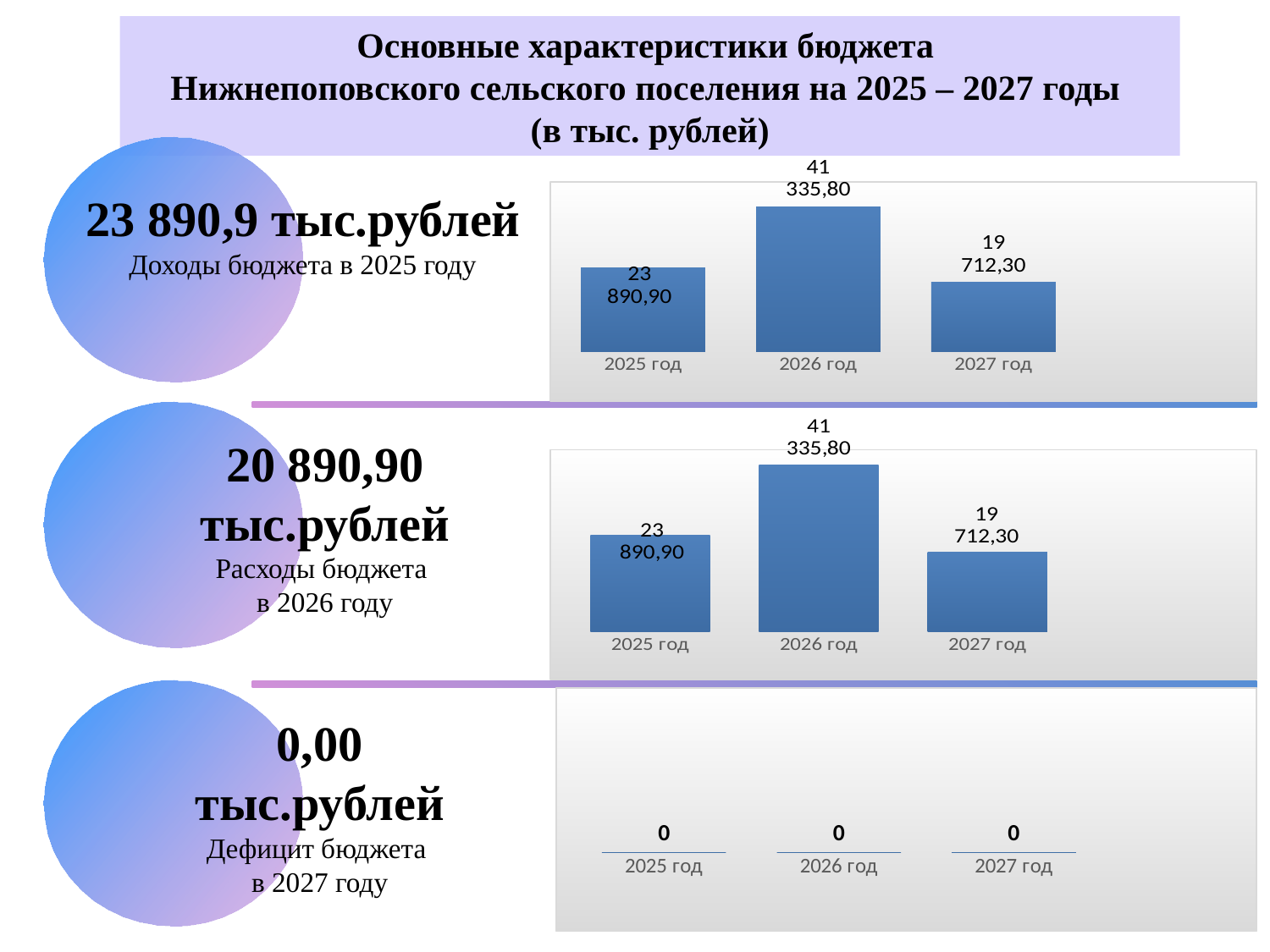
In the bottom chart, what is the value for 2026 год? 0 In the top chart, what is the value for 2026 год? 41 335,80 In the top chart, which year has the lowest value? 2027 год In the middle chart, which is larger, the value for 2025 год or the value for 2027 год? 2025 год In the middle chart, what is the difference between the values for 2026 год and 2025 год? 17 444,90 In the middle chart, what is the value for 2027 год? 19 712,30 In the top chart, what is the value for 2025 год? 23 890,90 In the top chart, what is the difference between the values for 2025 год and 2027 год? 4 178,60 What type of chart is the middle chart? bar chart How many bars are shown in the top chart? 3 In the top chart, which year has the highest value? 2026 год How many categories are shown in the bottom chart? 3